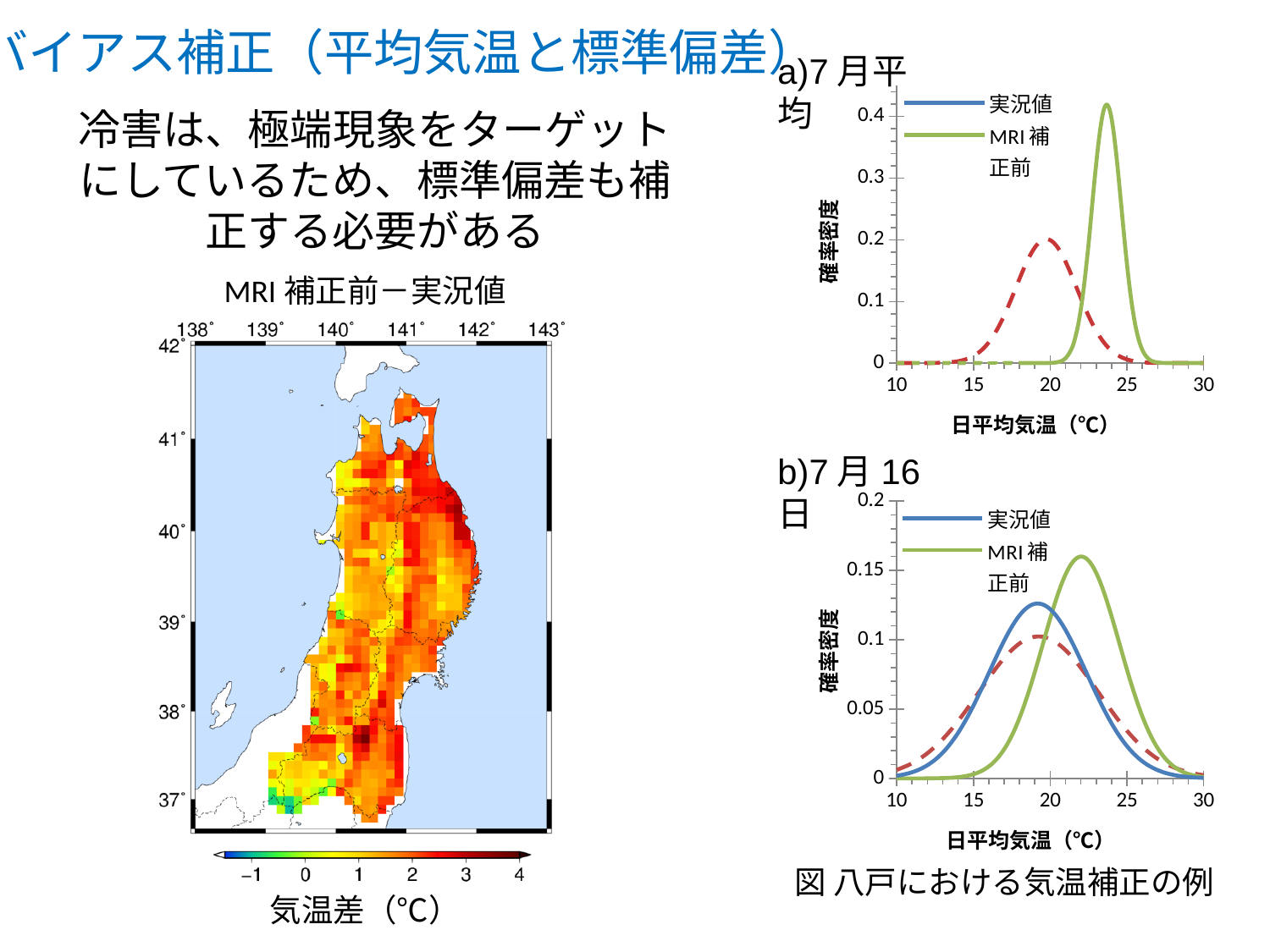
In the chart titled b)7月16日, which curve reaches a higher peak, 実況値 or MRI補正前? MRI補正前 What kind of chart is the chart titled a)7月平均? line chart How many series does the legend of the chart titled b)7月16日 list? 2 In the chart titled a)7月平均, is the peak value of the MRI補正前 curve greater or less than 0.4? greater In the chart titled a)7月平均, is the peak value of the MRI補正前 curve greater or less than 0.3? greater In the chart titled b)7月16日, is the value of the MRI補正前 curve at 15℃ greater or less than 0.05? less What is the y-axis label of the chart titled b)7月16日? 確率密度 In the chart titled b)7月16日, which curve peaks at a higher temperature, 実況値 or MRI補正前? MRI補正前 What are the two legend entries in the chart titled a)7月平均? 実況値 and MRI補正前